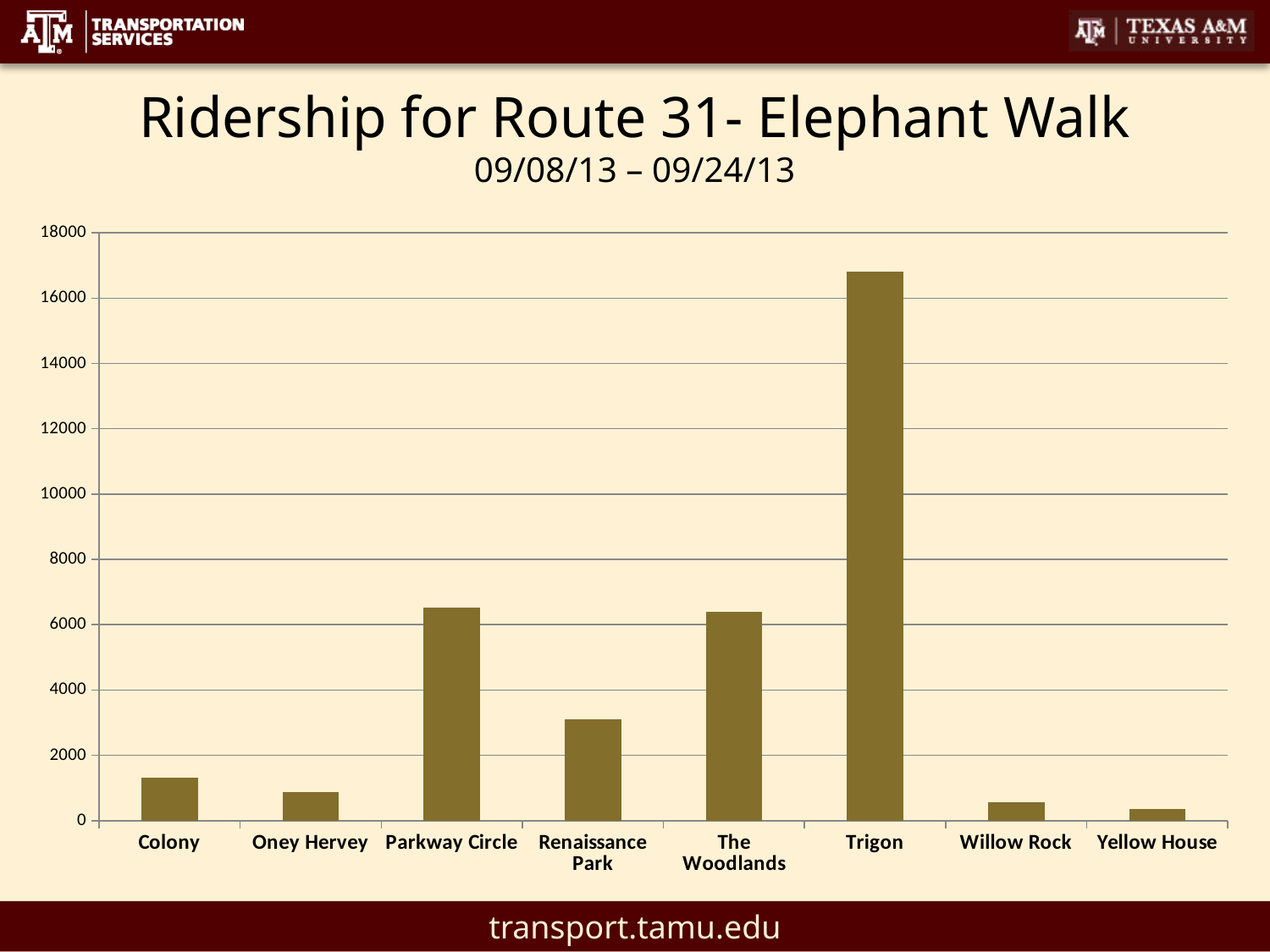
Is the ridership for Renaissance Park greater or less than 2000? greater What type of chart is shown on the slide? Bar chart Which has higher ridership, Renaissance Park or Oney Hervey? Renaissance Park Is the ridership for Renaissance Park greater or less than 4000? less Is the ridership for Trigon greater or less than 16000? greater Which stop has the lowest ridership on the chart? Yellow House Which stop has the highest ridership on the chart? Trigon How many stops are shown on the chart? 8 Which has higher ridership, Trigon or Parkway Circle? Trigon